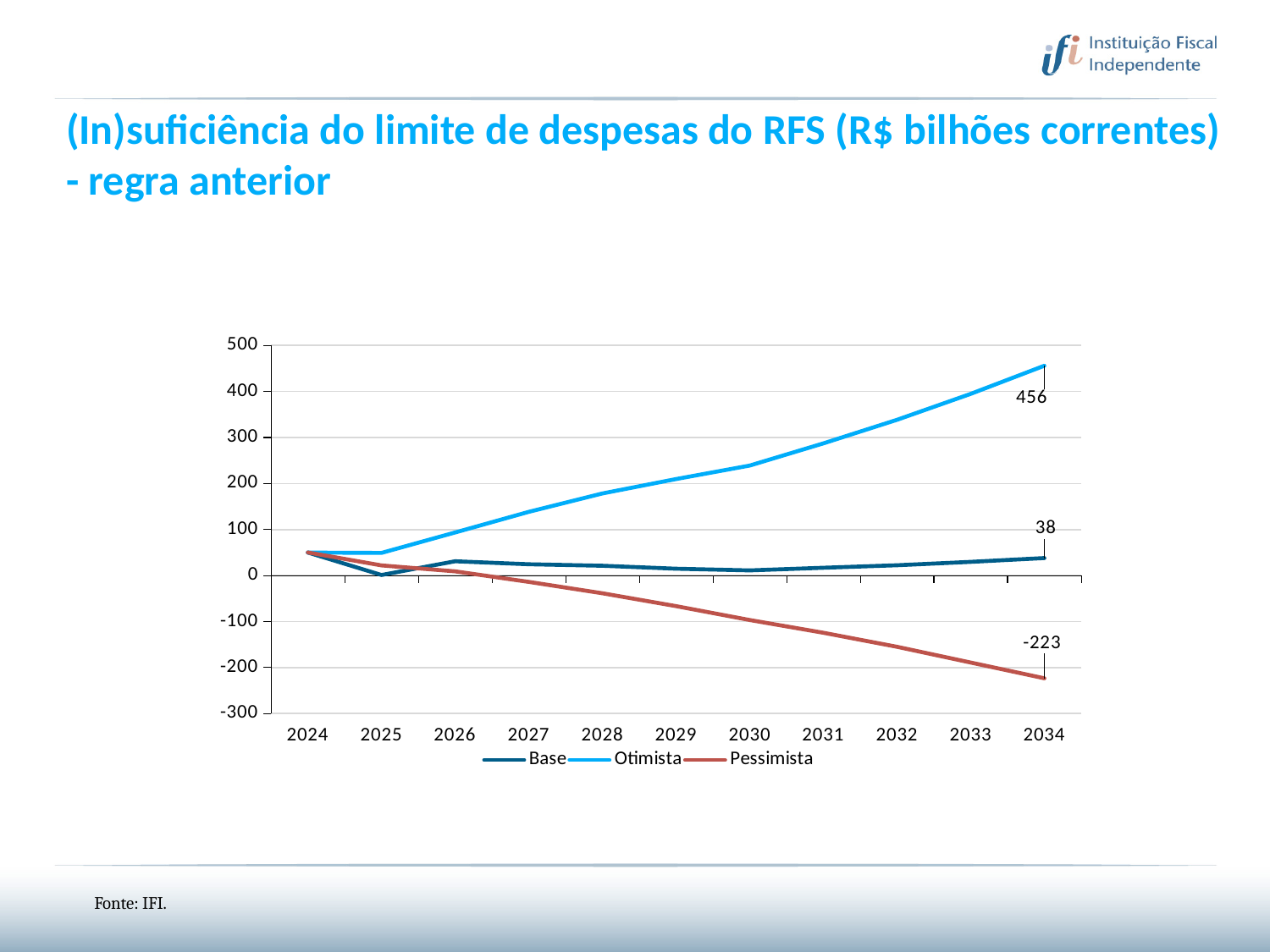
What kind of chart is shown on the slide? Line chart What is the value of the Otimista series in 2034? 456 Which series has the lowest value in 2034? Pessimista Is the value of the Otimista series in 2030 greater or less than 200? greater What is the difference between the Base and Pessimista values in 2034? 261 In 2034, which is larger: the Otimista value or the Base value? Otimista Is the value of the Pessimista series in 2032 greater or less than -100? less What is the value of the Base series in 2034? 38 What is the value of the Pessimista series in 2034? -223 How many series does the legend list? 3 Which series has the highest value in 2034? Otimista What is the difference between the Otimista and Base values in 2034? 418